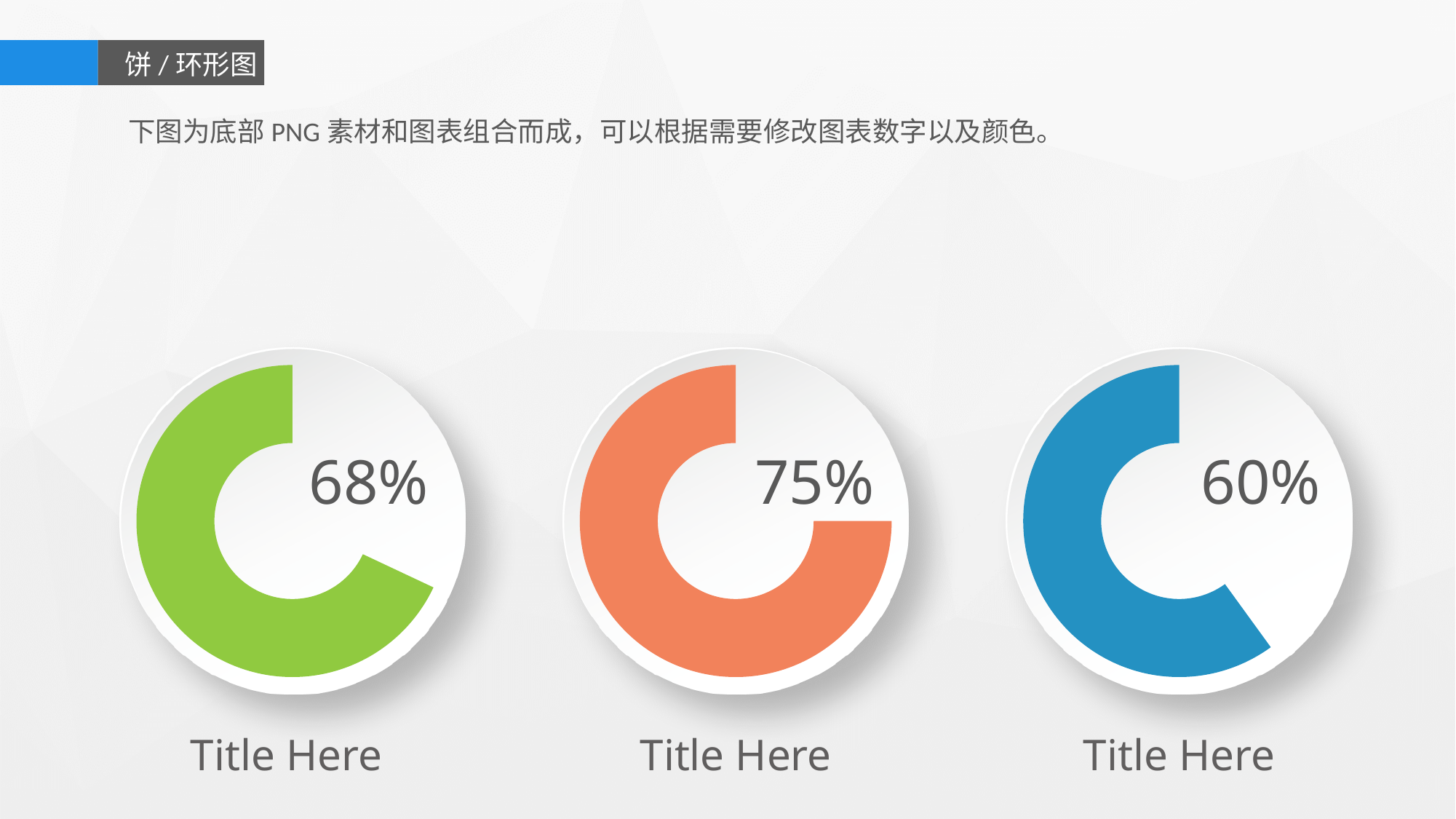
Which of the three donut charts shows the lowest percentage: left, middle or right? right What is the difference between the percentage in the middle donut chart and the percentage in the right donut chart? 15% What value is shown in the middle donut chart? 75% What colour is the filled ring of the middle donut chart? orange How many donut charts are on the slide? 3 Which is larger, the value in the left donut chart or the value in the middle donut chart? middle What value is shown in the left donut chart? 68% What is the difference between the percentage in the left donut chart and the percentage in the right donut chart? 8% What value is shown in the right donut chart? 60% Which of the three donut charts shows the highest percentage: left, middle or right? middle What kind of chart is used on this slide? donut chart Is the value in the right donut chart greater or less than 50%? greater